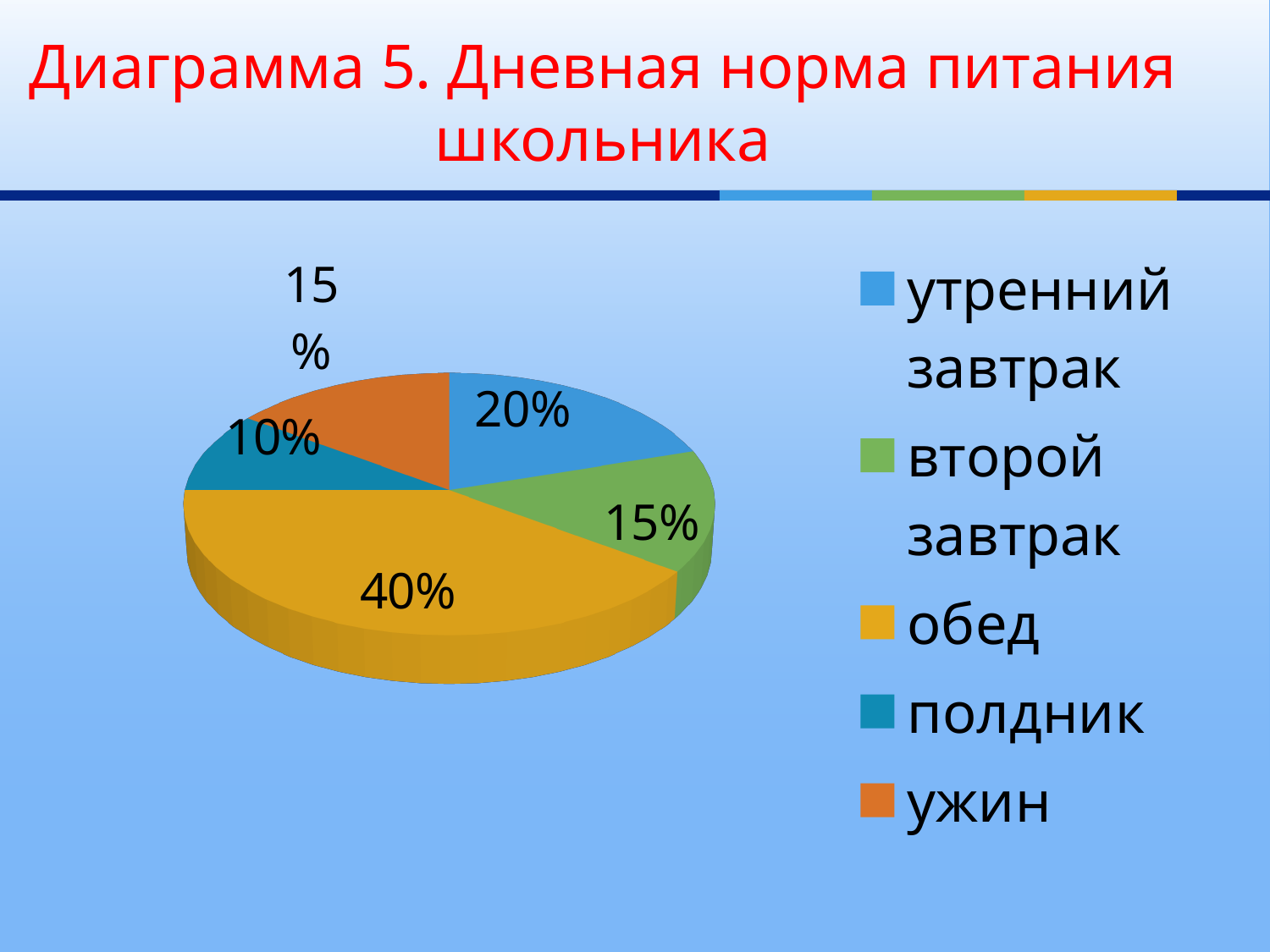
What is the difference between the shares of обед and утренний завтрак? 20% What is the value for полдник? 10% What is the value for второй завтрак? 15% Which category has the smallest share of the pie? полдник What is the value for утренний завтрак? 20% What share of the pie does обед take? 40% What colour is the slice for обед? yellow Which category has the largest share of the pie? обед How many categories does the legend list? 5 What is the value for ужин? 15% What kind of chart is shown on the slide? pie chart Which is larger, the share for утренний завтрак or the share for полдник? утренний завтрак